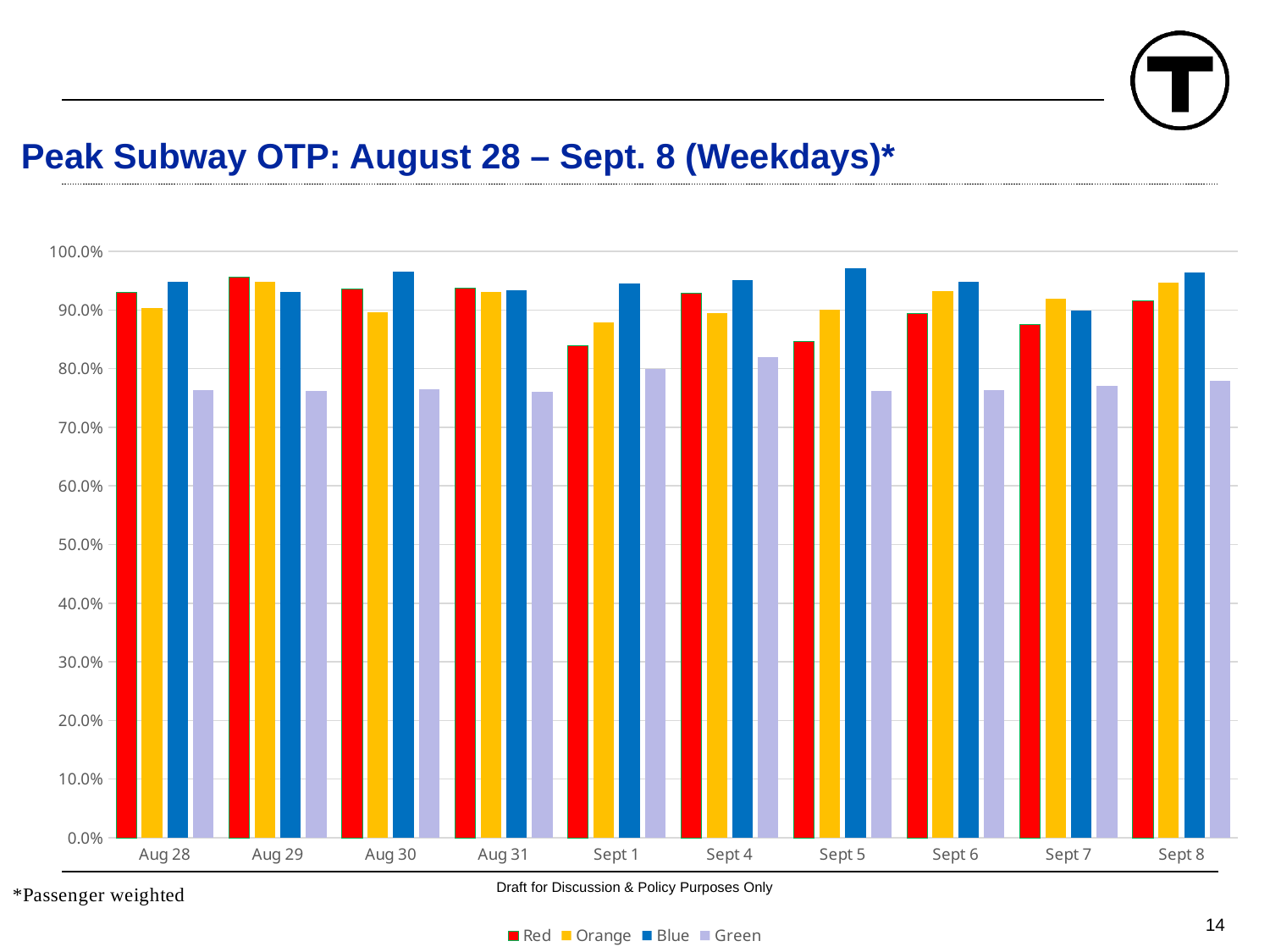
On Sept 1, which is larger, the Red value or the Blue value? Blue Is the value for Green on Aug 28 greater or less than 80.0%? less How many dates are shown along the x axis? 10 What is the title of the chart? Peak Subway OTP: August 28 – Sept. 8 (Weekdays)* On Sept 7, which is larger, the Orange value or the Red value? Orange Is the value for Red on Sept 1 greater or less than 90.0%? less What kind of chart is shown on the slide? Bar chart Which line has the lowest value on Sept 1? Green What is the highest tick label on the y axis? 100.0% How many series does the legend list? 4 Which line has the highest value on Sept 5? Blue Is the value for Blue on Sept 5 greater or less than 90.0%? greater